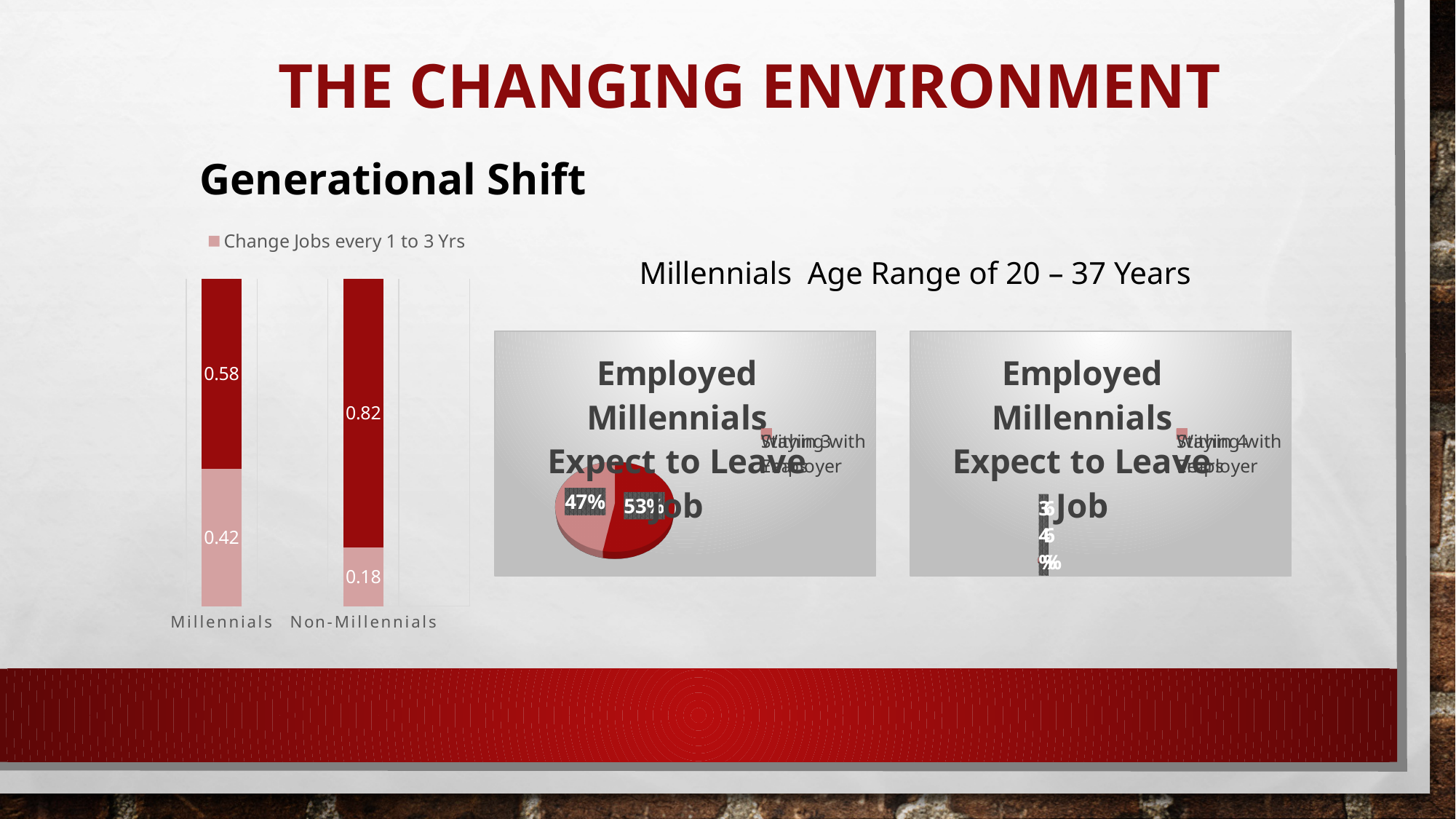
In the 'Generational Shift' bar chart, what is the difference between the dark red segment values for Non-Millennials (0.82) and Millennials (0.58)? 0.24 In the middle pie chart 'Employed Millennials Expect to Leave Job', what is the share of the larger slice? 53% In the 'Generational Shift' bar chart, what is the value of the light pink (bottom) segment for Millennials? 0.42 In the 'Generational Shift' bar chart, which category has the larger dark red (top) segment, Millennials or Non-Millennials? Non-Millennials How many categories are shown on the x axis of the 'Generational Shift' bar chart? 2 In the 'Generational Shift' bar chart, what is the value of the dark red (top) segment for Non-Millennials? 0.82 In the 'Generational Shift' bar chart, what is the total of the two segments in the Millennials bar? 1 What kind of chart is the middle chart titled 'Employed Millennials Expect to Leave Job'? pie chart In the 'Generational Shift' bar chart, what is the value of the dark red (top) segment for Millennials? 0.58 In the 'Generational Shift' bar chart, what is the value of the light pink (bottom) segment for Non-Millennials? 0.18 What text does the legend of the 'Generational Shift' bar chart show? Change Jobs every 1 to 3 Yrs What kind of chart is the 'Generational Shift' chart on the left of the slide? bar chart